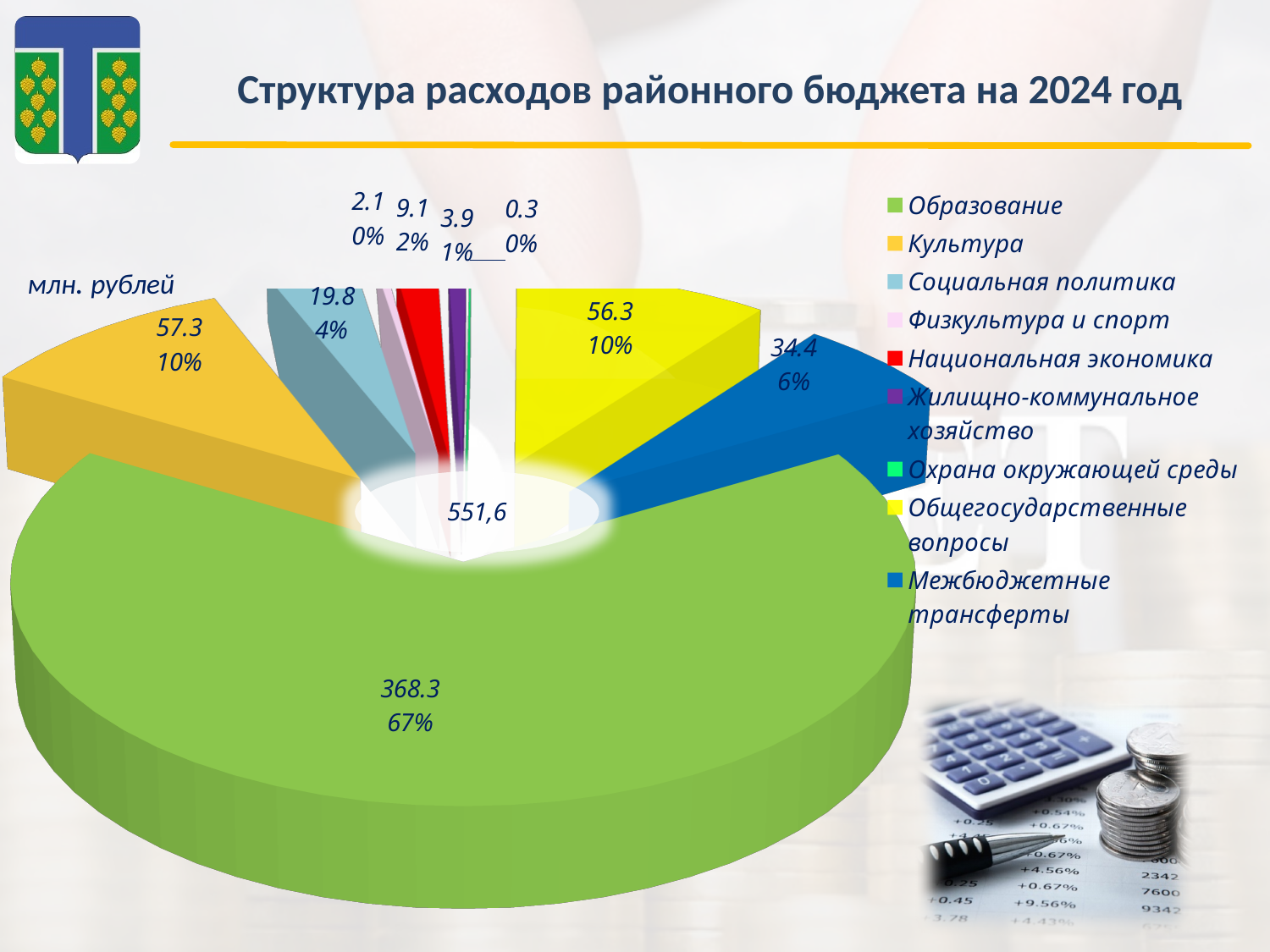
What is the value for Социальная политика? 19.8 What share of the pie does Образование take? 67% What kind of chart is shown on the slide? pie chart What share of the pie does Межбюджетные трансферты take? 6% Which is larger, the value for Культура or the value for Общегосударственные вопросы? Культура What is the difference between the values for Образование and Культура? 311 What is the value for Культура? 57.3 How many categories does the legend list? 9 What is the value for Межбюджетные трансферты? 34.4 Which category has the largest slice of the pie? Образование What is the value for Образование on the pie chart? 368.3 What is the value for Общегосударственные вопросы? 56.3